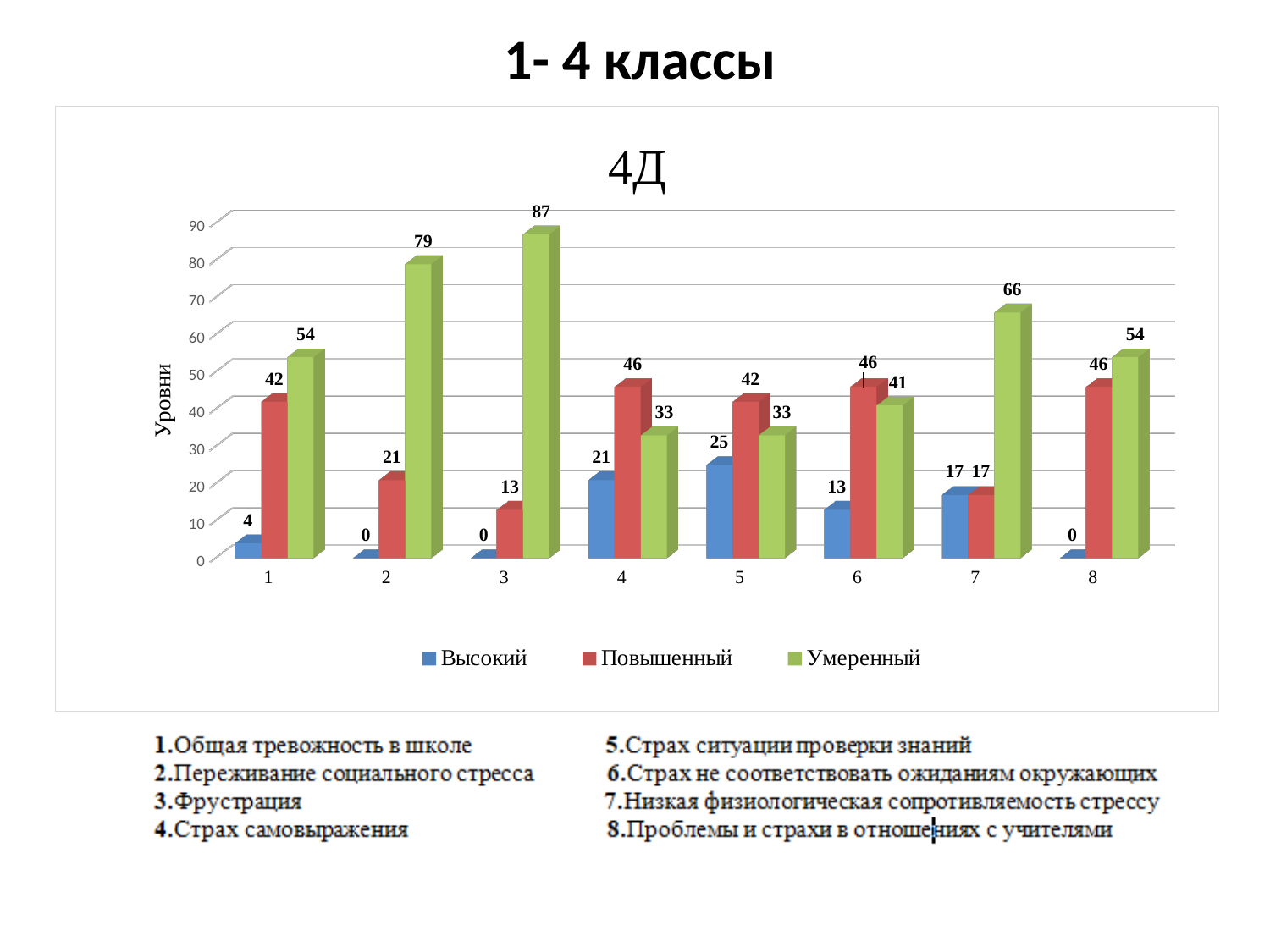
What is the title of the chart? 4Д Which is larger for category 4: the Повышенный value or the Умеренный value? Повышенный What kind of chart is shown? Bar chart What is the label of the vertical axis? Уровни What is the difference between the Умеренный and Повышенный values for category 2? 58 How many series does the legend list? 3 Which category has the highest value in the Умеренный series? 3 What is the value of the Высокий series for category 5? 25 What is the value of the Умеренный series for category 3? 87 How many categories are shown on the x axis? 8 What is the value of the Повышенный series for category 1? 42 Which category has the highest value in the Высокий series? 5